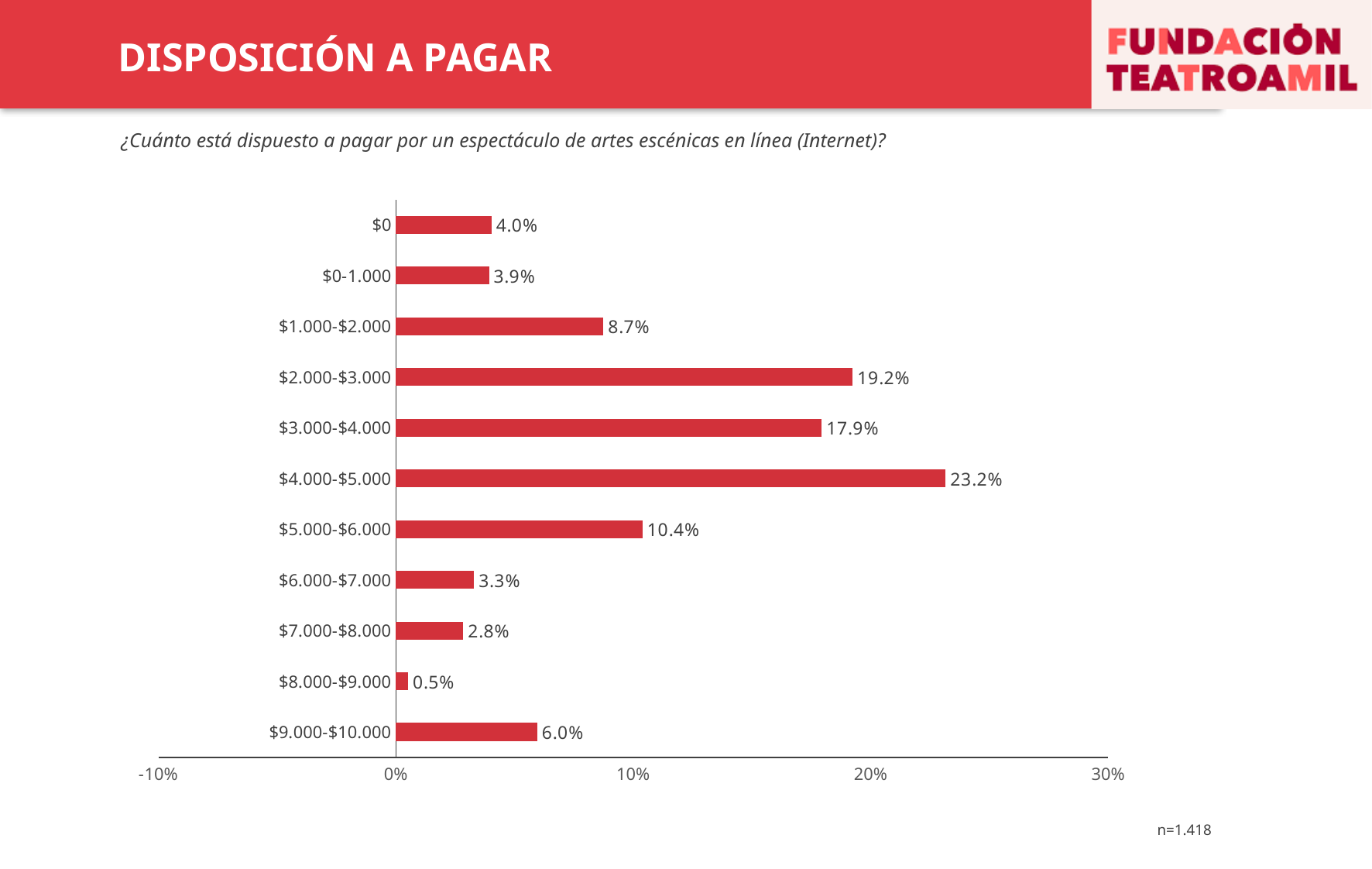
Which is larger, the value for $5.000-$6.000 or the value for $9.000-$10.000? $5.000-$6.000 What is the value shown for the $1.000-$2.000 category? 8.7% Which price range has the lowest percentage? $8.000-$9.000 Which price range has the highest percentage? $4.000-$5.000 How many price categories are shown in the chart? 11 What percentage of respondents are willing to pay $4.000-$5.000? 23.2% What is the difference between the $0 and $0-1.000 values? 0.1% What is the sample size (n) noted on the slide? n=1.418 What is the difference between the $2.000-$3.000 and $3.000-$4.000 values? 1.3% What kind of chart is shown on the slide? bar chart Is the value for $3.000-$4.000 greater or less than 10%? greater What percentage is shown for $8.000-$9.000? 0.5%